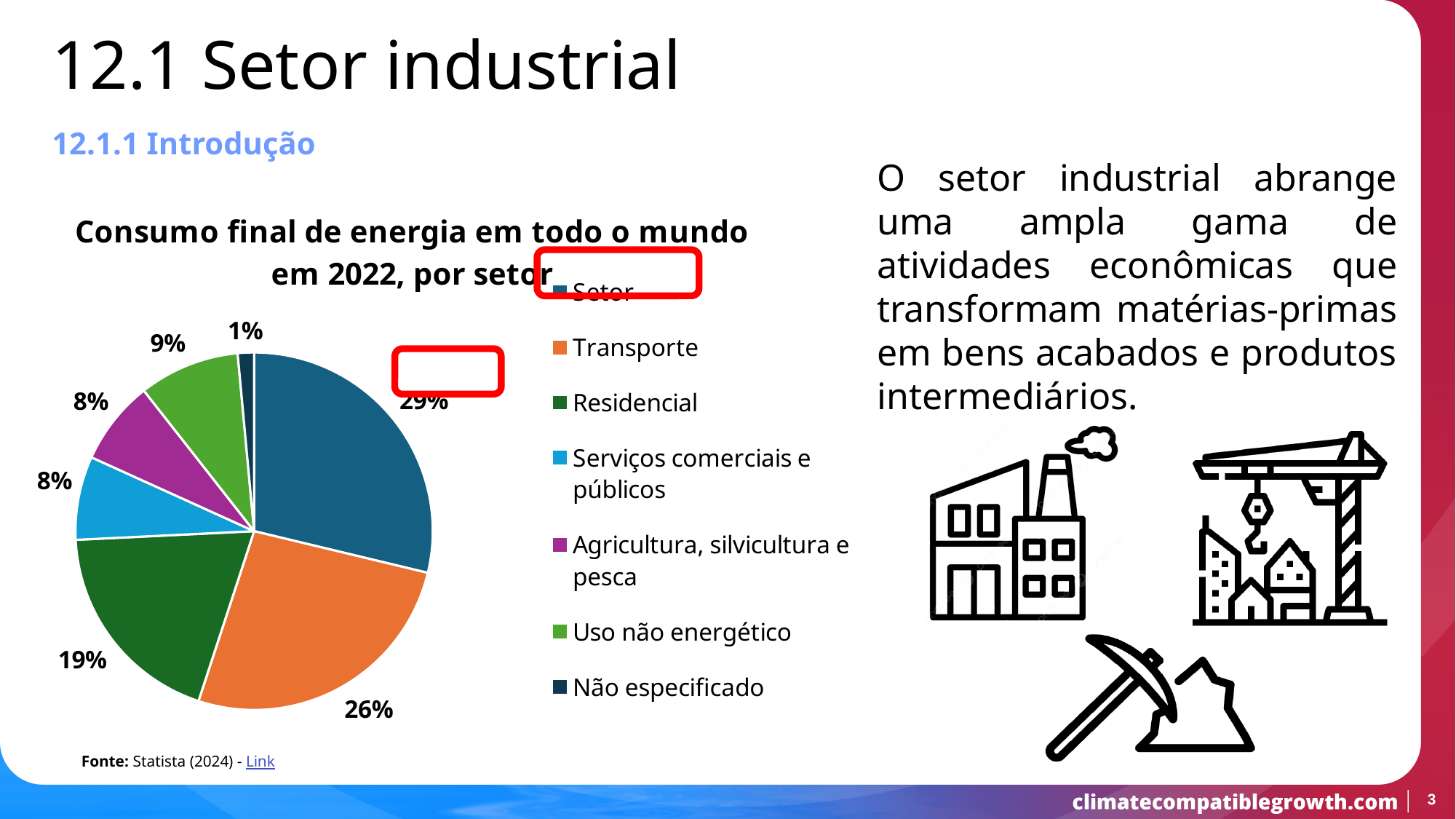
What is the largest percentage shown on the pie chart? 29% What is the title of the pie chart? Consumo final de energia em todo o mundo em 2022, por setor What share of final energy consumption does Residencial account for? 19% Which has a larger share, Uso não energético or Serviços comerciais e públicos? Uso não energético Which sector has the smallest share of the pie? Não especificado What kind of chart is shown on the slide? pie chart What share does Uso não energético account for? 9% What is the difference between the shares of Transporte and Residencial? 7% What share of final energy consumption does Transporte account for? 26% How many entries does the legend list? 7 What share does Agricultura, silvicultura e pesca account for? 8% What share does Não especificado account for? 1%